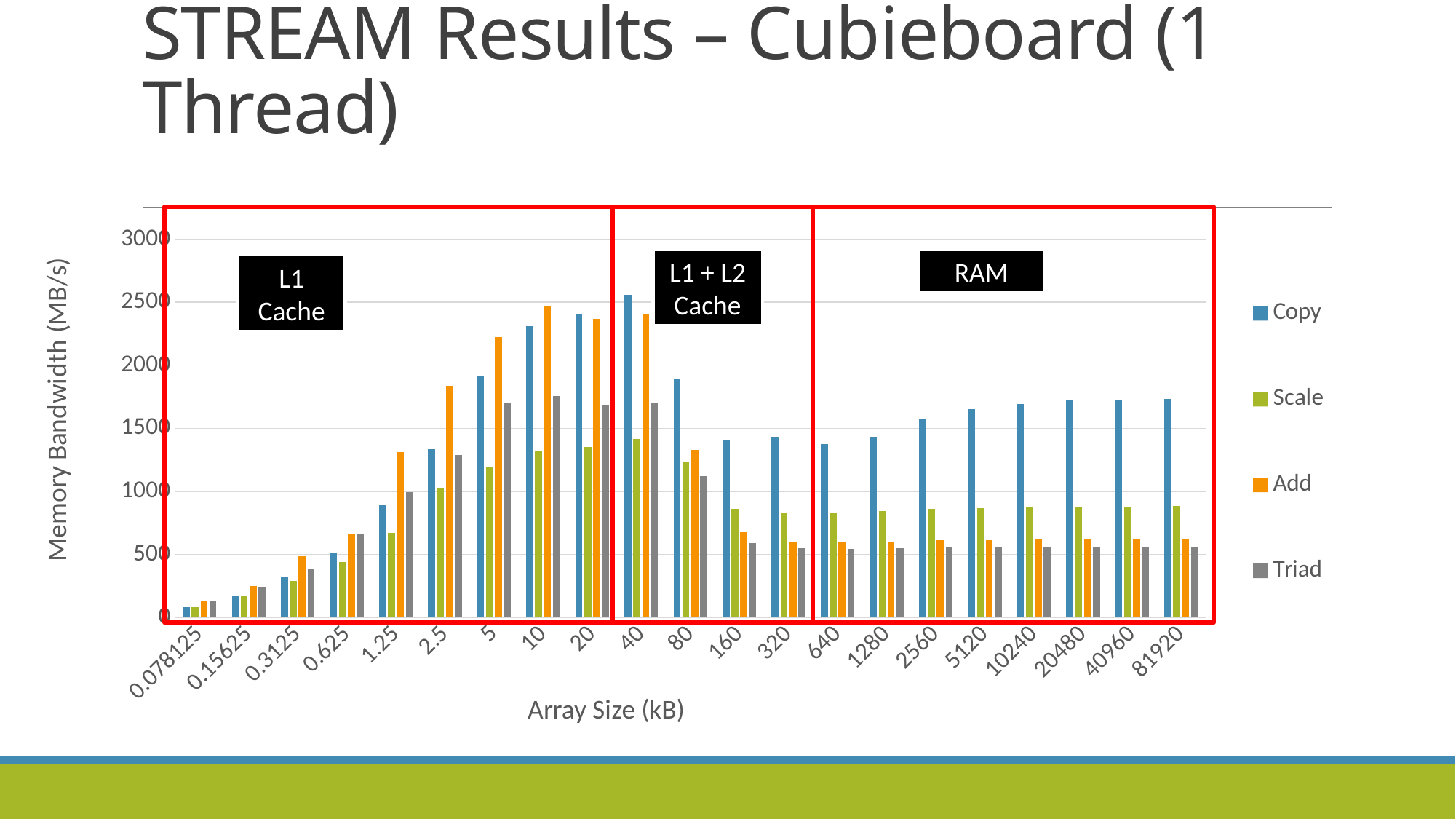
What kind of chart is shown on the slide? bar chart What label is shown in the black box over the rightmost red region of the chart? RAM At which array size is the Copy series lowest? 0.078125 Is the Copy value at array size 640 greater or less than 1500? less How many array sizes are shown along the x axis? 21 At which array size does the Copy series reach its highest memory bandwidth? 40 How many series does the legend list? 4 Is the Add value at array size 81920 greater or less than 1000? less Is the Triad value at array size 10 greater or less than 1500? greater At array size 2.5, which is larger, Copy or Add? Add Does the Copy series rise or fall as the array size increases from 640 to 81920? rise